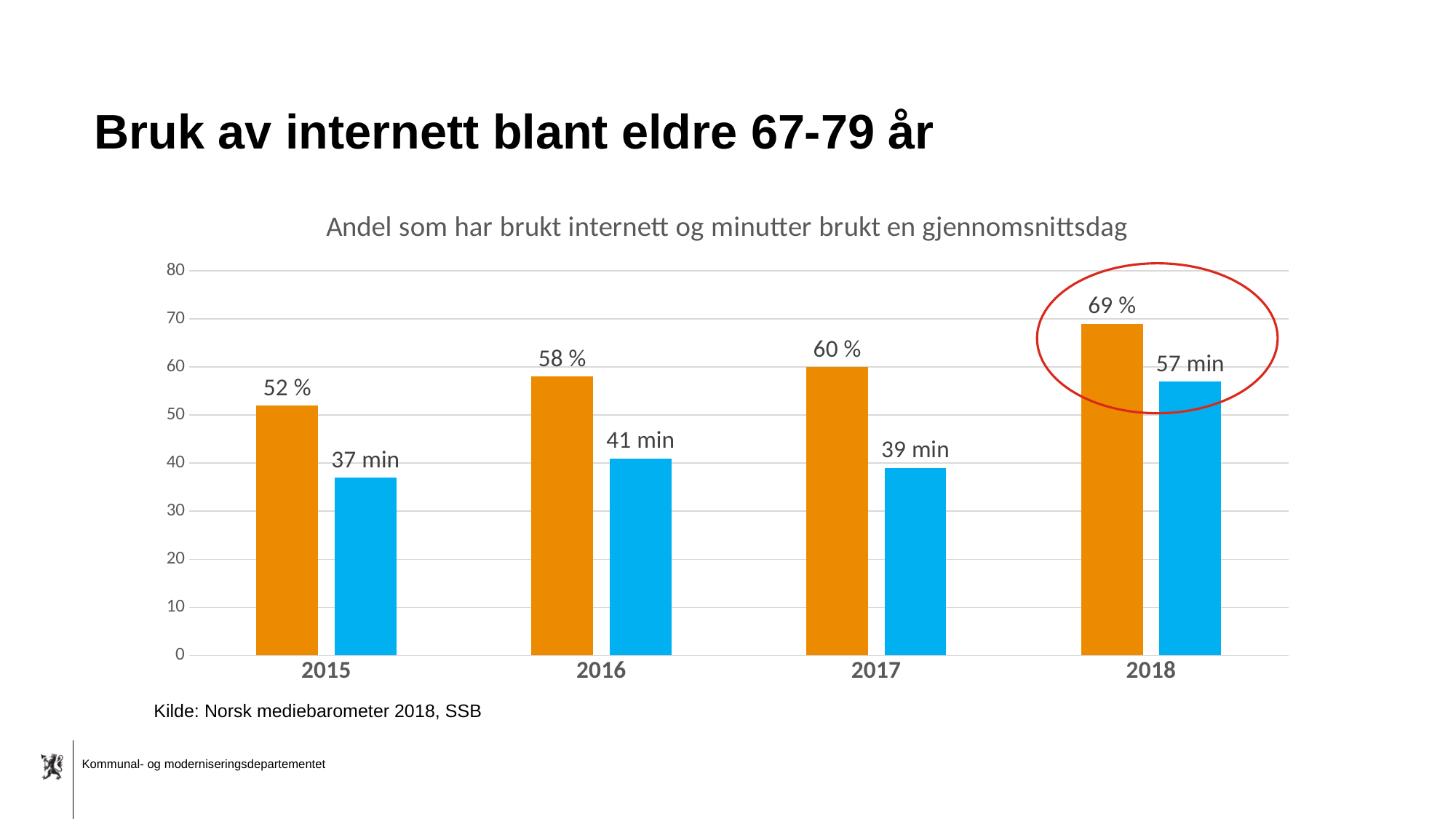
How many minutes were spent on the internet on an average day in 2017? 39 min What is the share of internet users in 2018? 69 % Does the share of internet users rise or fall from 2015 to 2018? Rise Which year has more minutes of daily internet use, 2016 or 2017? 2016 What is the difference in the share of internet users between 2015 and 2018? 17 percentage points By how many minutes did daily internet use increase from 2017 to 2018? 18 min In which year is the share of internet users highest? 2018 How many years are shown on the x axis? 4 In which year is the number of minutes spent on the internet lowest? 2015 What kind of chart is shown on the slide? Bar chart What is the chart's title? Andel som har brukt internett og minutter brukt en gjennomsnittsdag What is the share of people aged 67-79 who used the internet in 2015? 52 %